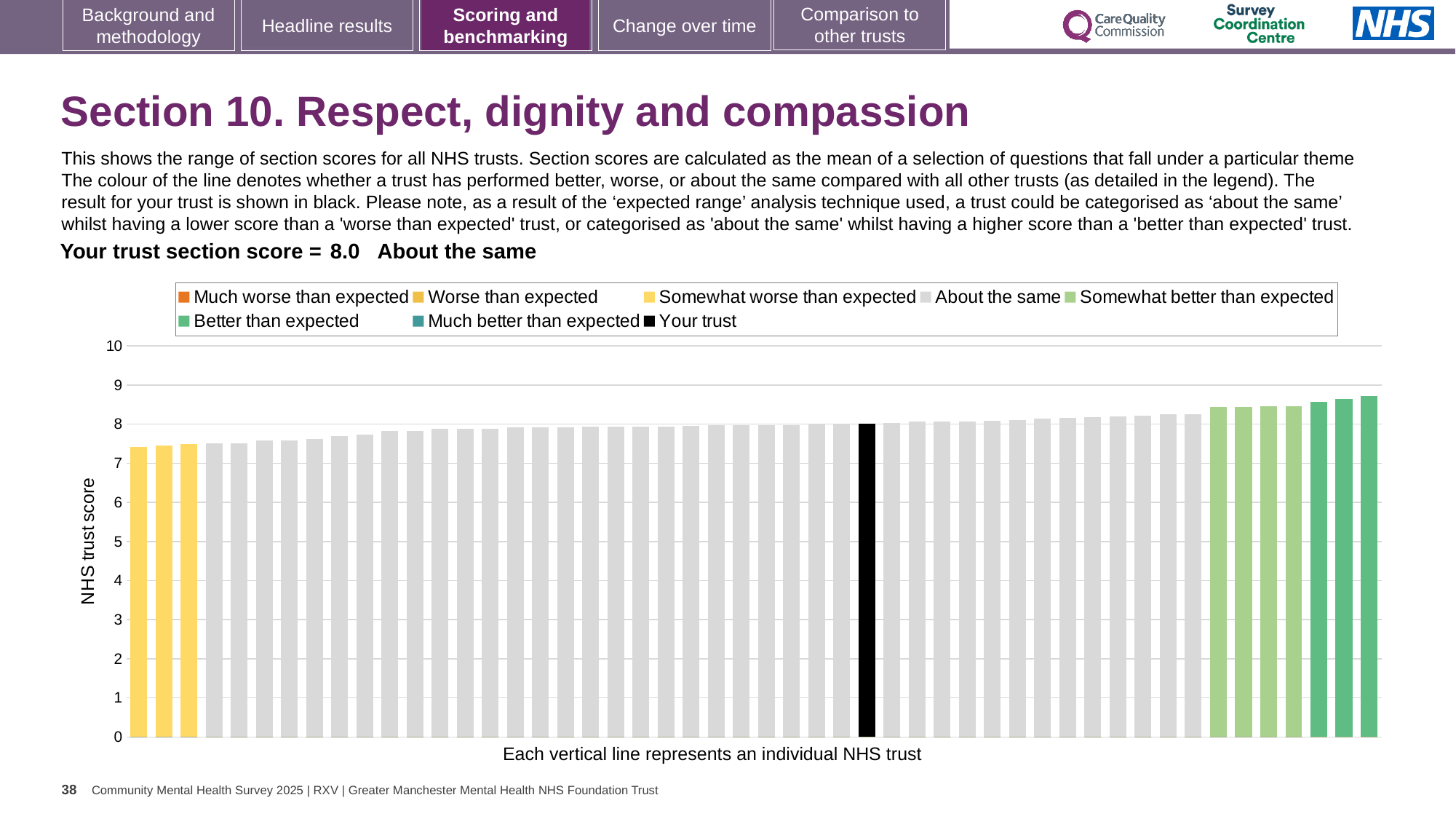
What colour is the bar representing Your trust? black Is the value for Your trust greater or less than 5? greater Is the value of the lowest bar greater or less than 7? greater What category does Your trust fall into according to the slide? About the same Do the bar values rise or fall from left to right along the x axis? rise What is the section score for Your trust shown on the slide? 8.0 What kind of chart is shown on the slide? bar chart What is the label on the y axis of the chart? NHS trust score How many entries does the chart legend list? 8 Is the value of the highest bar greater or less than 9? less